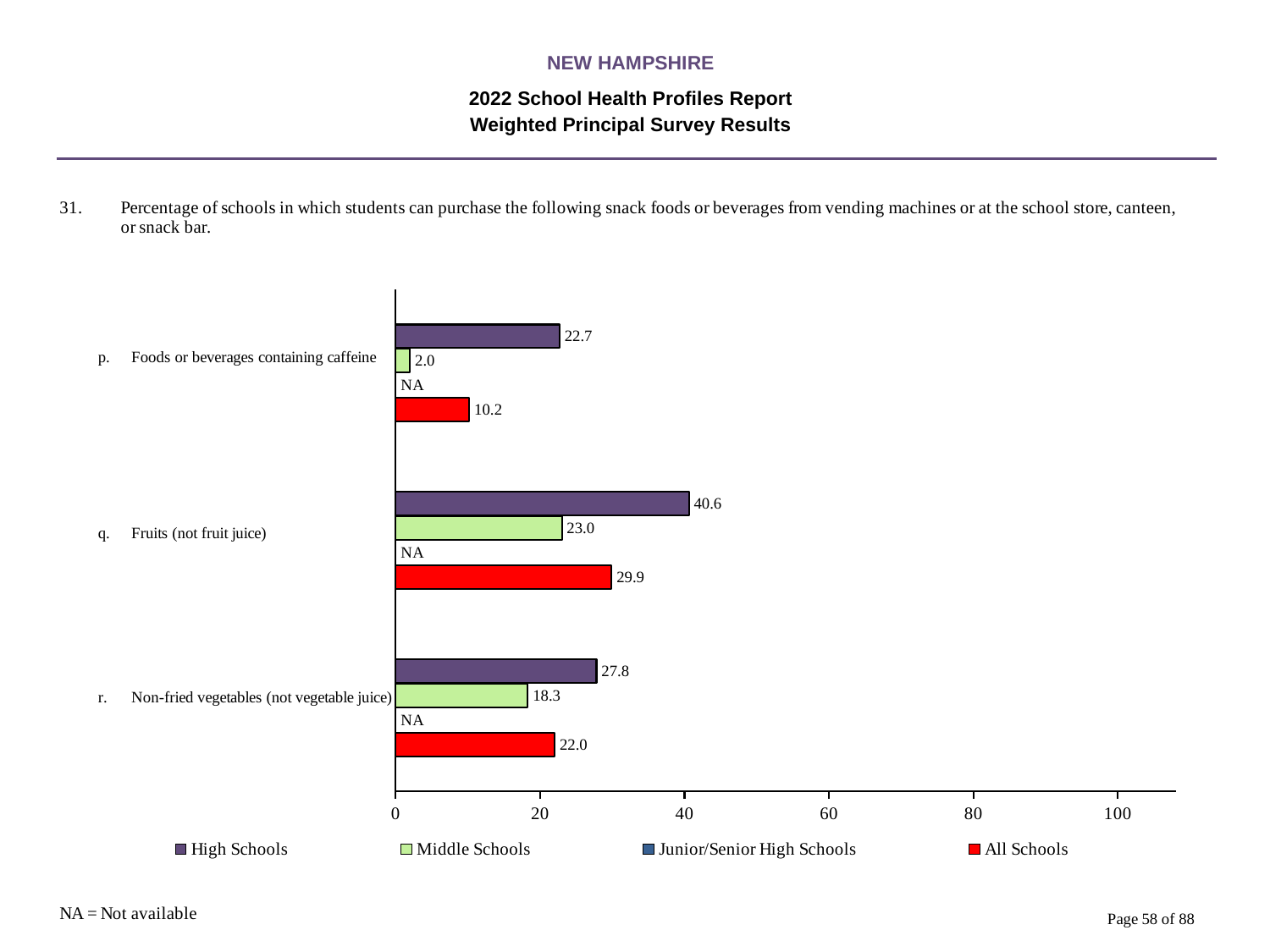
What percentage of High Schools allow students to purchase foods or beverages containing caffeine? 22.7 Is the High Schools value for Fruits (not fruit juice) greater or less than 40? greater What kind of chart is shown on the slide? bar chart Which category has the highest High Schools value? Fruits (not fruit juice) How many snack food or beverage categories are shown on the chart? 3 What is the All Schools value for Fruits (not fruit juice)? 29.9 What is the Middle Schools value for Non-fried vegetables (not vegetable juice)? 18.3 How many series does the legend list? 4 What is the difference between the High Schools and Middle Schools values for Fruits (not fruit juice)? 17.6 Which category has the lowest Middle Schools value? Foods or beverages containing caffeine Which is larger for Non-fried vegetables (not vegetable juice): the High Schools value or the All Schools value? High Schools What value is shown for Junior/Senior High Schools for Fruits (not fruit juice)? NA